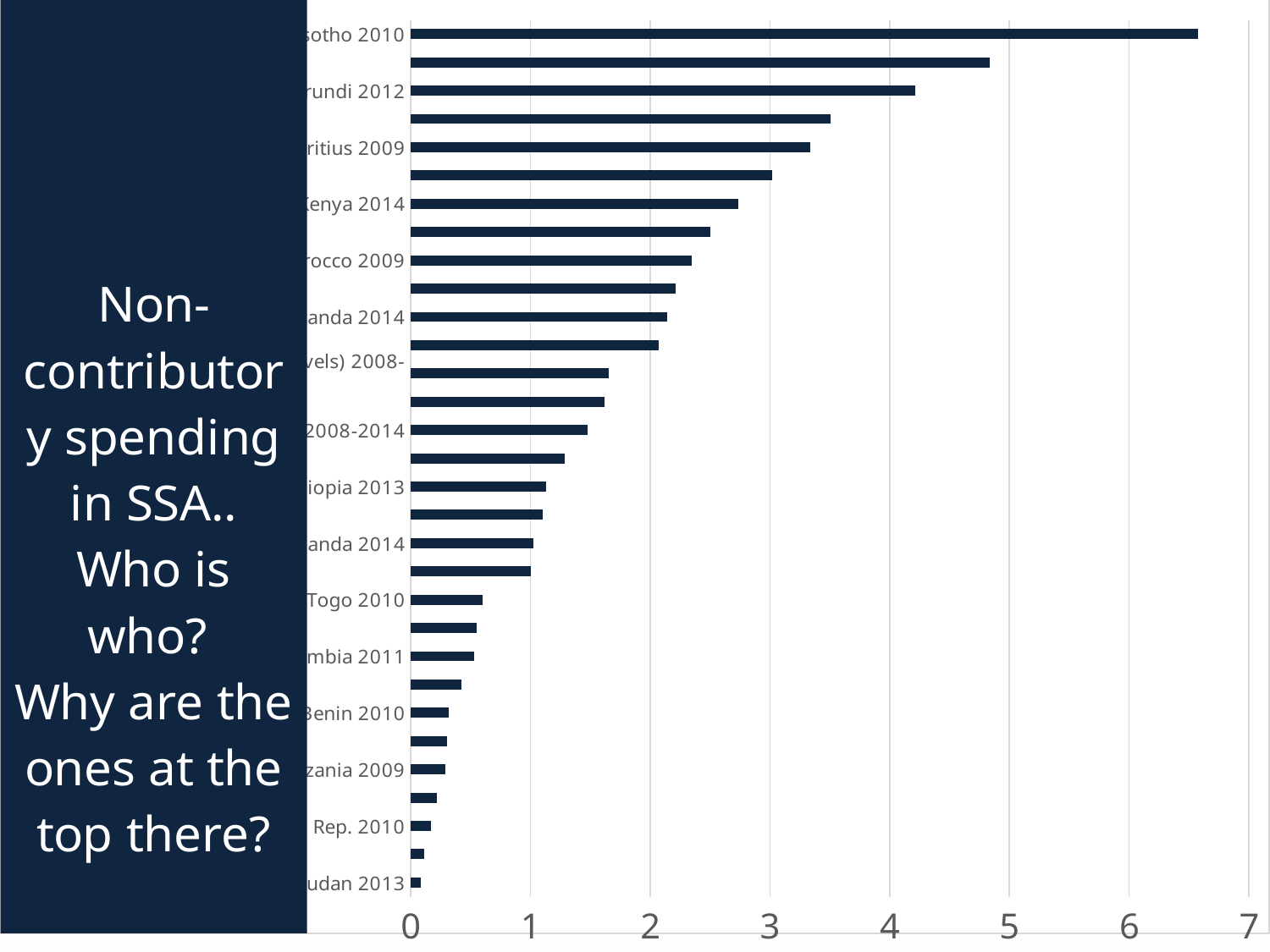
Is the longest bar in the chart greater or less than 6? greater Which has the larger value, Togo 2010 or Benin 2010? Togo 2010 Is the value for Togo 2010 greater or less than 1? less Which has the larger value, Kenya 2014 or Benin 2010? Kenya 2014 Which has the larger value, Kenya 2014 or Togo 2010? Kenya 2014 What is the highest value shown on the horizontal axis? 7 Is the value for Kenya 2014 greater or less than 3? less What colour are the bars in the chart? dark navy blue Do the bar lengths increase or decrease going from the top of the chart to the bottom? decrease What kind of chart is shown on the slide? bar chart